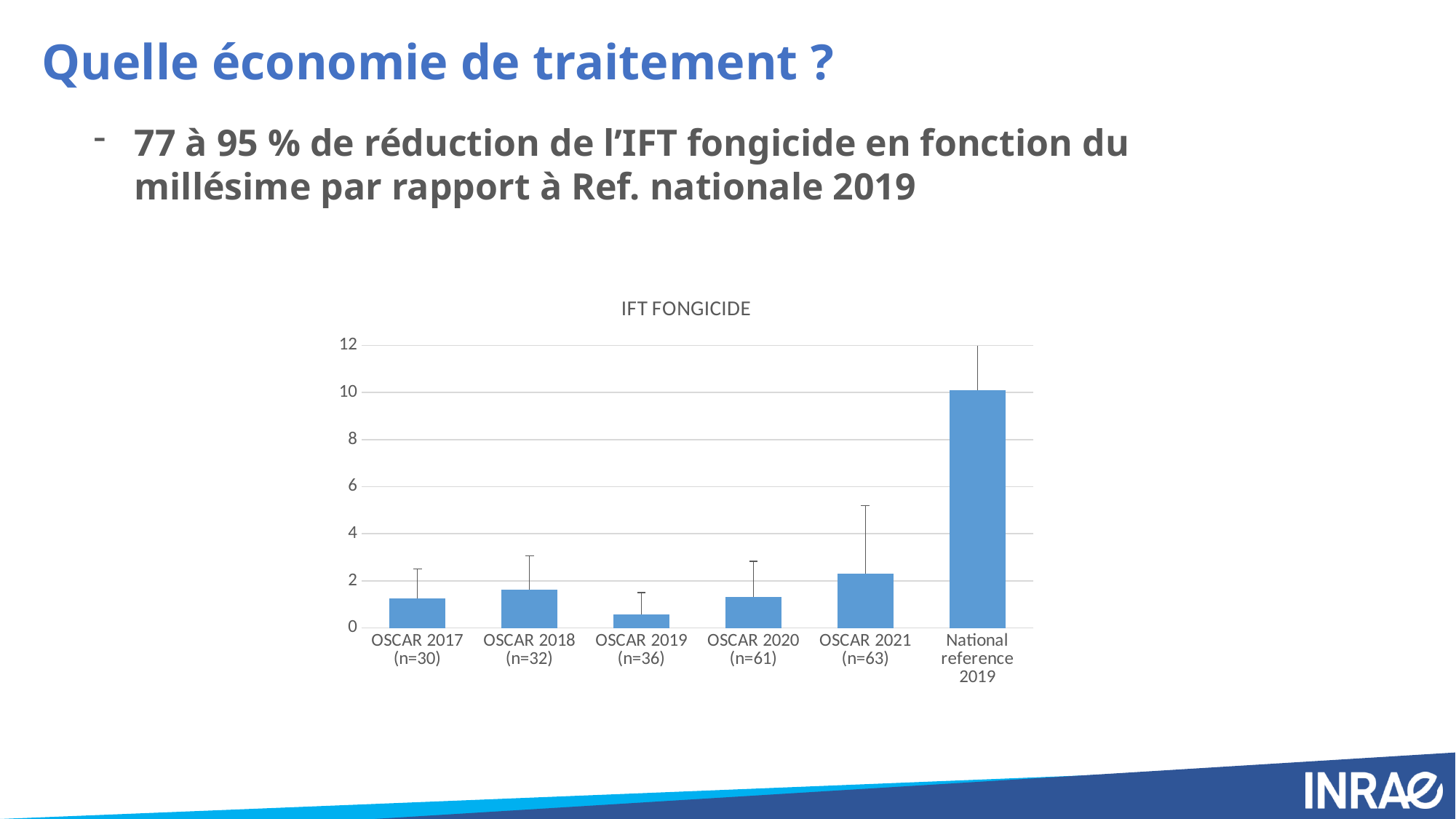
What kind of chart is shown under the title "IFT FONGICIDE"? bar chart Which category has the lowest bar in the IFT FONGICIDE chart? OSCAR 2019 (n=36) How many categories are plotted on the x axis of the IFT FONGICIDE chart? 6 Which is larger, the bar for National reference 2019 or the bar for OSCAR 2021 (n=63)? National reference 2019 Which is larger, the bar for OSCAR 2021 (n=63) or the bar for OSCAR 2019 (n=36)? OSCAR 2021 (n=63) Is the value for National reference 2019 greater or less than 8? greater Is the value for OSCAR 2019 (n=36) greater or less than 2? less What is the highest tick value shown on the y axis of the IFT FONGICIDE chart? 12 What is the title of the chart on the slide? IFT FONGICIDE Is the value for OSCAR 2021 (n=63) greater or less than 4? less Which category has the highest bar in the IFT FONGICIDE chart? National reference 2019